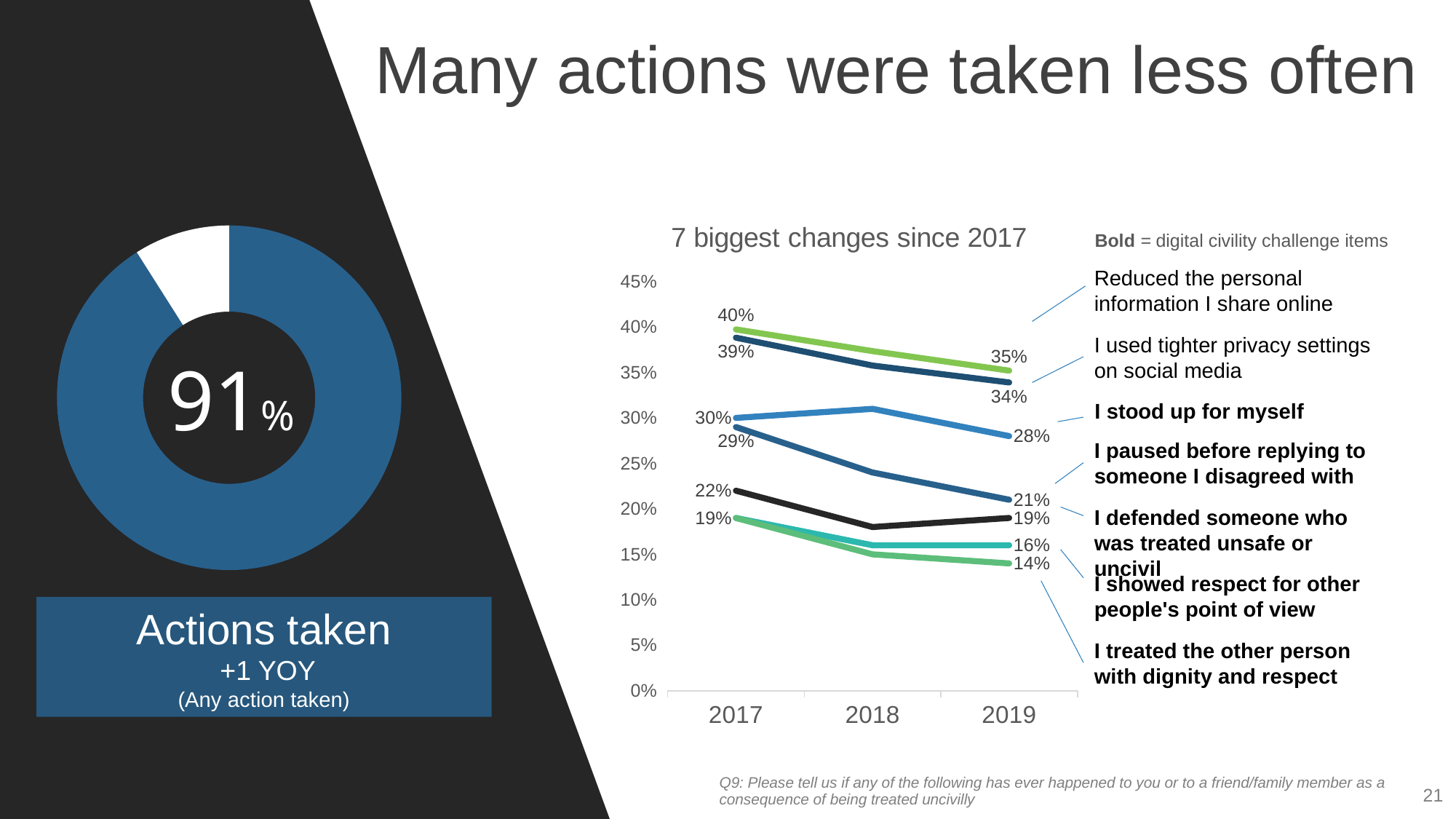
In the '7 biggest changes since 2017' chart, what is the 2019 value for 'Reduced the personal information I share online'? 35% What kind of chart is '7 biggest changes since 2017'? line chart How many items (series) are plotted in the '7 biggest changes since 2017' chart? 7 In the '7 biggest changes since 2017' chart, does the value for 'I paused before replying to someone I disagreed with' rise or fall from 2017 to 2019? fall In the donut chart on the left, what percentage is shown for actions taken? 91% In the '7 biggest changes since 2017' chart, which item has the lowest value in 2019? I treated the other person with dignity and respect In the '7 biggest changes since 2017' chart, which had the higher value in 2019: 'I stood up for myself' or 'I paused before replying to someone I disagreed with'? I stood up for myself In the '7 biggest changes since 2017' chart, which item has the highest value in 2019? Reduced the personal information I share online In the '7 biggest changes since 2017' chart, what is the 2019 value for 'I treated the other person with dignity and respect'? 14% How many years are shown on the x axis of the '7 biggest changes since 2017' chart? 3 In the '7 biggest changes since 2017' chart, what is the 2017 value for 'I paused before replying to someone I disagreed with'? 29% In the '7 biggest changes since 2017' chart, by how many percentage points did 'Reduced the personal information I share online' fall from 2017 to 2019? 5 percentage points